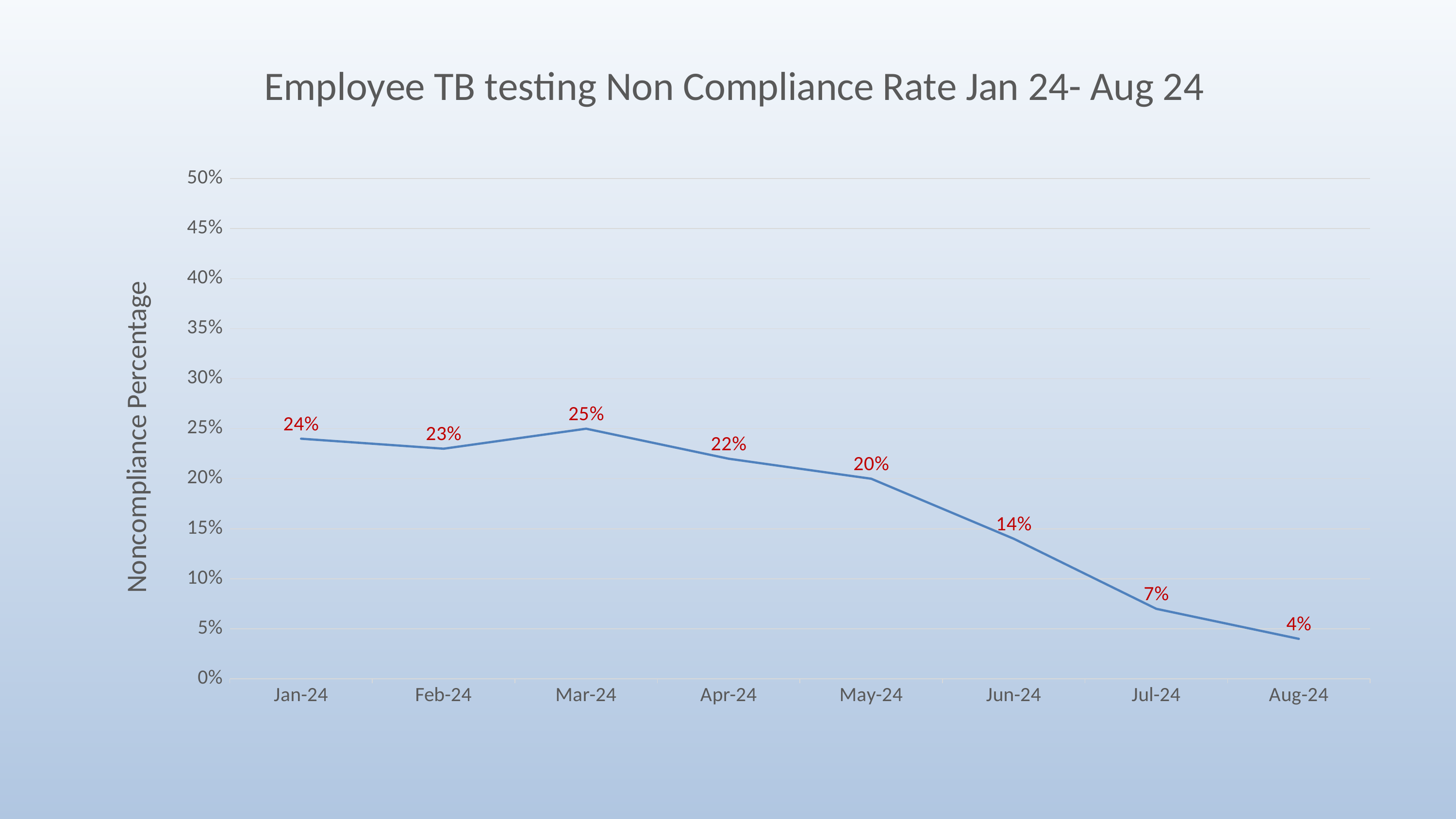
What is the difference between the noncompliance rates for Jan-24 and Aug-24? 20% Which month has a higher noncompliance rate, Feb-24 or Apr-24? Feb-24 What is the noncompliance rate for Jun-24? 14% What is the noncompliance rate for Aug-24? 4% What kind of chart is shown on the slide? Line chart What is the title of the chart? Employee TB testing Non Compliance Rate Jan 24- Aug 24 Which month has the highest noncompliance rate? Mar-24 Which month has the lowest noncompliance rate? Aug-24 How many months are plotted on the chart? 8 What is the difference between the noncompliance rates for May-24 and Jun-24? 6% What is the noncompliance rate for Jan-24? 24% Does the noncompliance rate generally rise or fall from Mar-24 to Aug-24? Fall